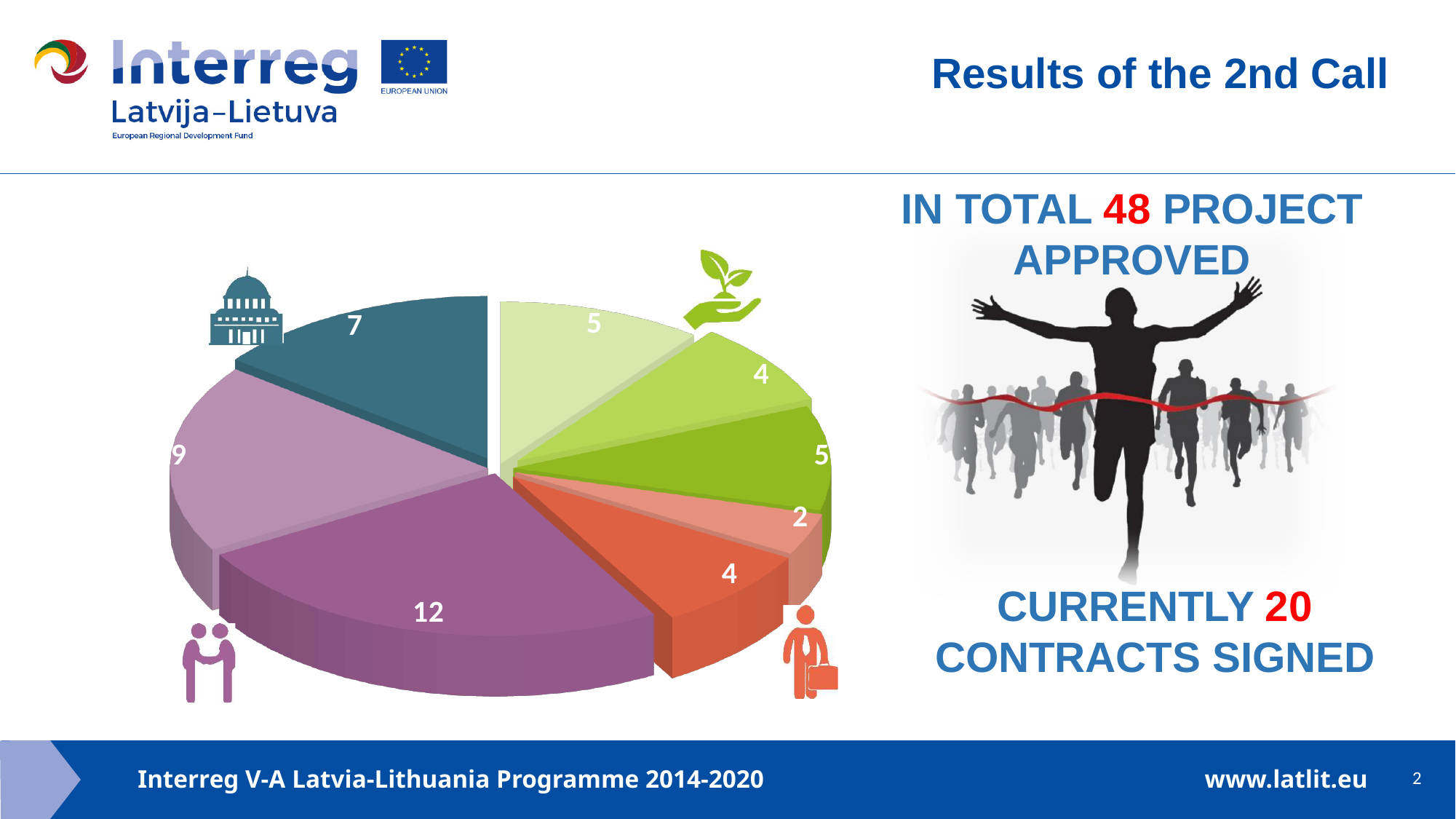
What is the value of the smallest slice in the pie chart? 2 What kind of chart is shown on the slide? Pie chart What is the total of all the slice values in the pie chart? 48 What is the difference between the largest slice (12) and the smallest slice (2) in the pie chart? 10 According to the text next to the chart, how many contracts are currently signed? 20 What share of the pie does the largest slice (12) represent? 25% What is the value of the largest slice in the pie chart? 12 How many slices does the pie chart have? 8 What is the value shown on the dark teal slice of the pie chart? 7 What is the difference between the dark teal slice (7) and the light purple slice (9) in the pie chart? 2 What is the value shown on the light purple slice of the pie chart? 9 Which is larger in the pie chart: the dark purple slice or the light purple slice? The dark purple slice